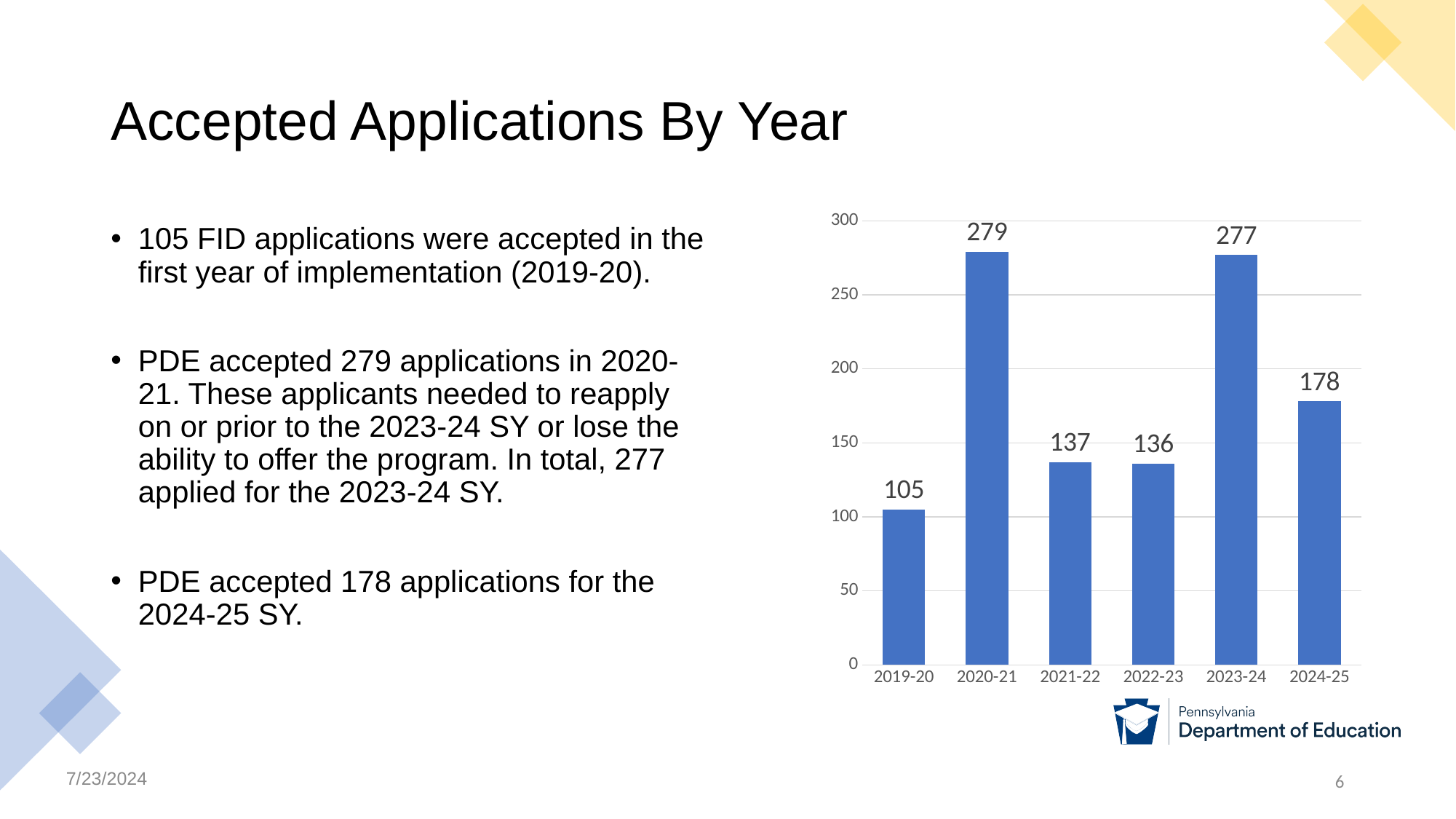
How many years are shown on the x axis? 6 What is the value for 2024-25? 178 What is the title of the slide containing the chart? Accepted Applications By Year Is the value for 2023-24 greater or less than 250? greater What is the difference between the values for 2023-24 and 2024-25? 99 Which year has the highest value? 2020-21 What is the value for 2022-23? 136 Which is larger, the value for 2024-25 or the value for 2021-22? 2024-25 Which year has the lowest value? 2019-20 What is the difference between the values for 2020-21 and 2019-20? 174 What kind of chart is shown on the slide? bar chart What is the value for 2019-20? 105